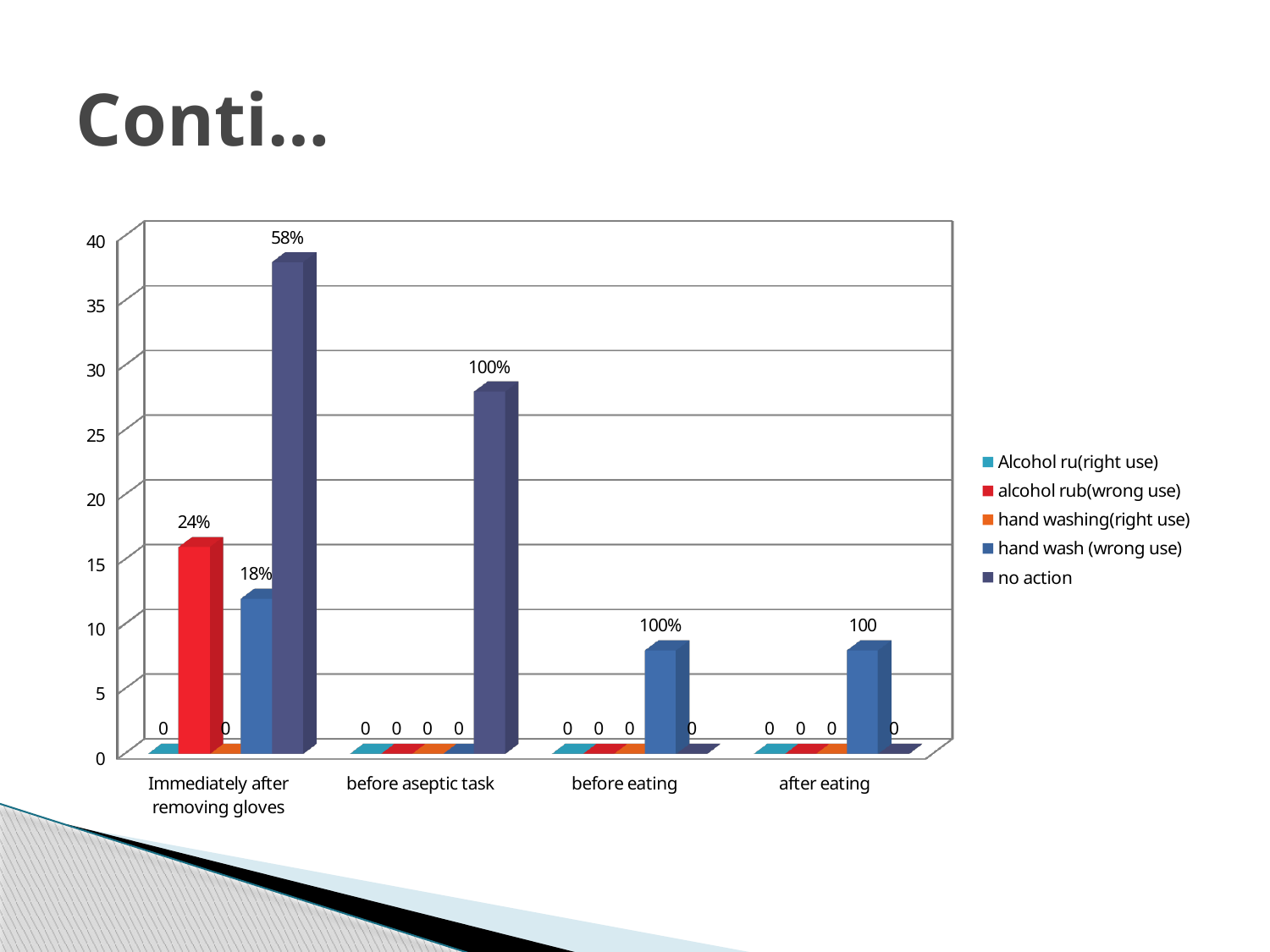
What kind of chart is shown on the slide? bar chart How many series does the chart's legend list? 5 In the 'Immediately after removing gloves' category, which is larger: 'alcohol rub(wrong use)' or 'hand wash (wrong use)'? alcohol rub(wrong use) What is the difference between the 'no action' label (58%) and the 'alcohol rub(wrong use)' label (24%) in the 'Immediately after removing gloves' category? 34% Which legend entry is shown in red? alcohol rub(wrong use) What is the data label for 'hand wash (wrong use)' in the 'Immediately after removing gloves' category? 18% How many categories are shown on the x axis of the chart? 4 Which series has the highest value in the 'Immediately after removing gloves' category? no action What is the data label for 'hand wash (wrong use)' in the 'after eating' category? 100 What is the data label for 'no action' in the 'Immediately after removing gloves' category? 58% What is the data label for 'alcohol rub(wrong use)' in the 'Immediately after removing gloves' category? 24% What is the data label for 'no action' in the 'before aseptic task' category? 100%